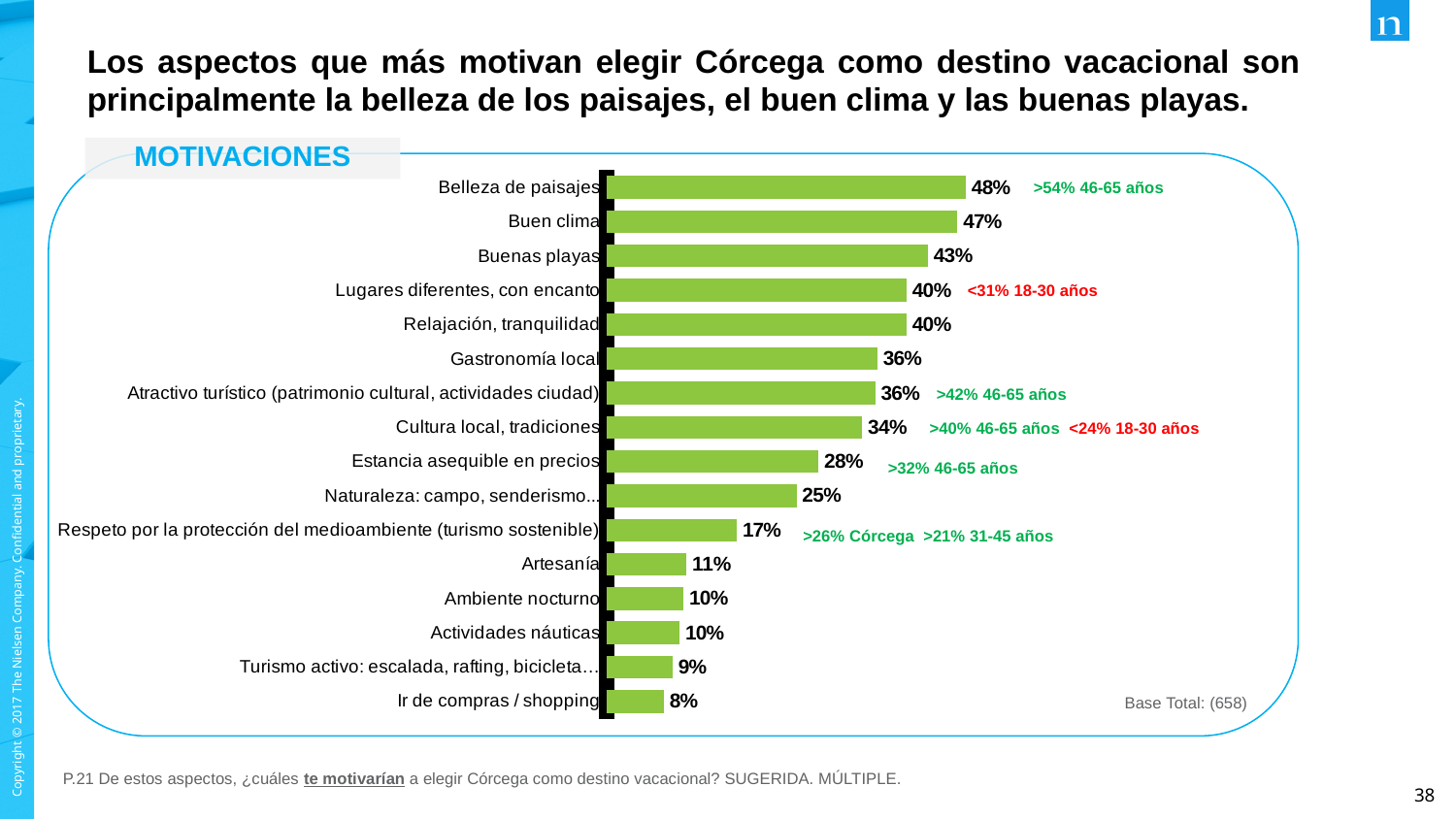
What is the difference in percentage points between "Buenas playas" and "Naturaleza: campo, senderismo..."? 18 percentage points What is the value shown for "Gastronomía local"? 36% What is the base total shown for the chart? 658 Which motivation has the lowest percentage in the chart? Ir de compras / shopping Which motivation has the highest percentage in the chart? Belleza de paisajes What percentage of respondents chose "Belleza de paisajes" as a motivation? 48% What is the difference in percentage points between "Belleza de paisajes" and "Buen clima"? 1 percentage point What percentage is shown for "Estancia asequible en precios"? 28% What type of chart is used on this slide? Bar chart How many motivation categories are shown in the chart? 16 Which has a higher value, "Cultura local, tradiciones" or "Respeto por la protección del medioambiente (turismo sostenible)"? Cultura local, tradiciones What is the value for "Artesanía"? 11%